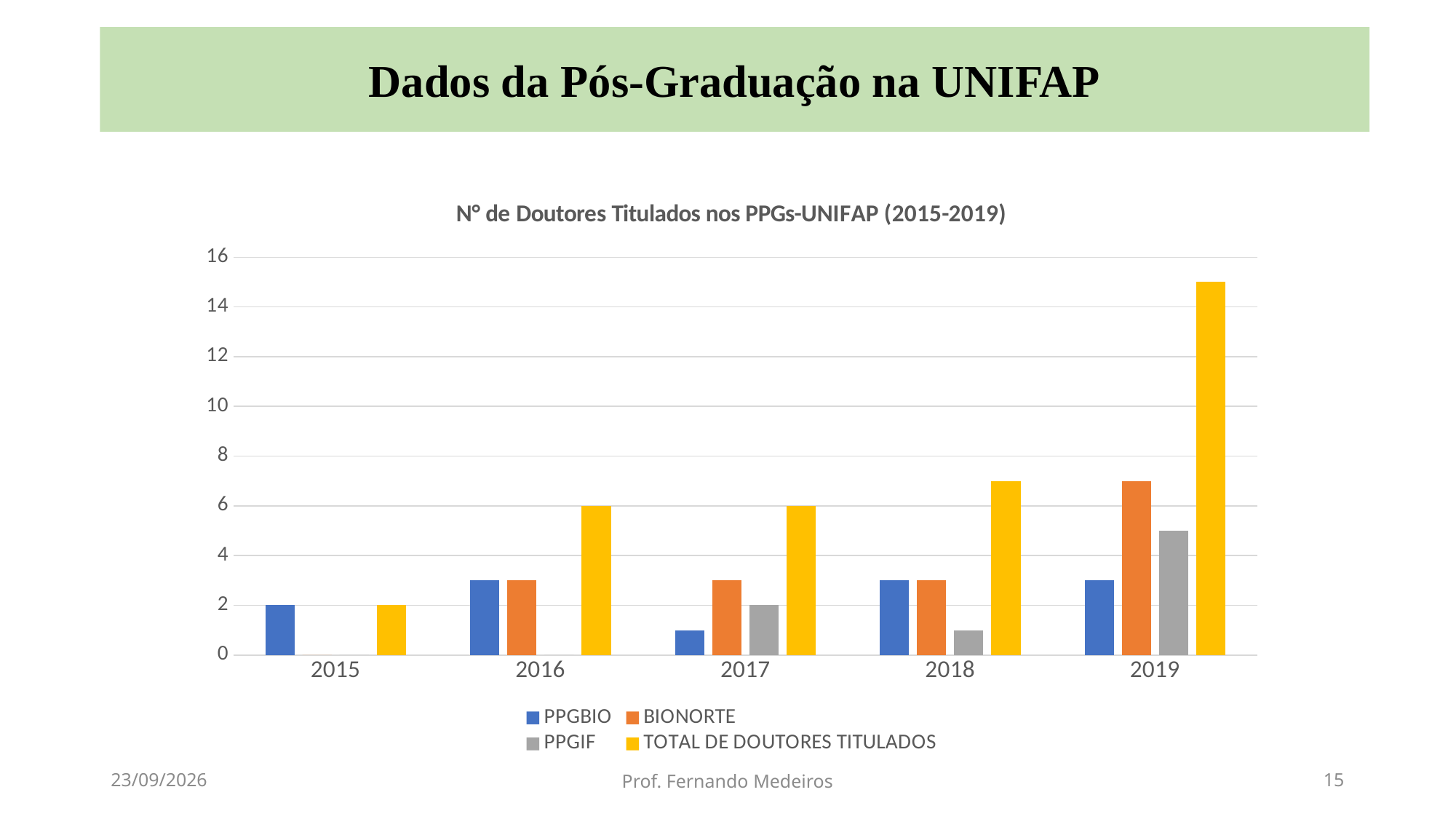
How many years are shown on the x axis? 5 What is the value of PPGIF for 2017? 2 What is the title of the chart? N° de Doutores Titulados nos PPGs-UNIFAP (2015-2019) Which is larger in 2019, BIONORTE or PPGIF? BIONORTE What is the value of TOTAL DE DOUTORES TITULADOS for 2016? 6 Is the value of TOTAL DE DOUTORES TITULADOS for 2019 greater or less than 14? greater What is the value of PPGBIO for 2015? 2 Is the value of BIONORTE for 2019 greater or less than 6? greater In which year is TOTAL DE DOUTORES TITULADOS lowest? 2015 In which year is TOTAL DE DOUTORES TITULADOS highest? 2019 How many series does the legend list? 4 What type of chart is shown on the slide? bar chart